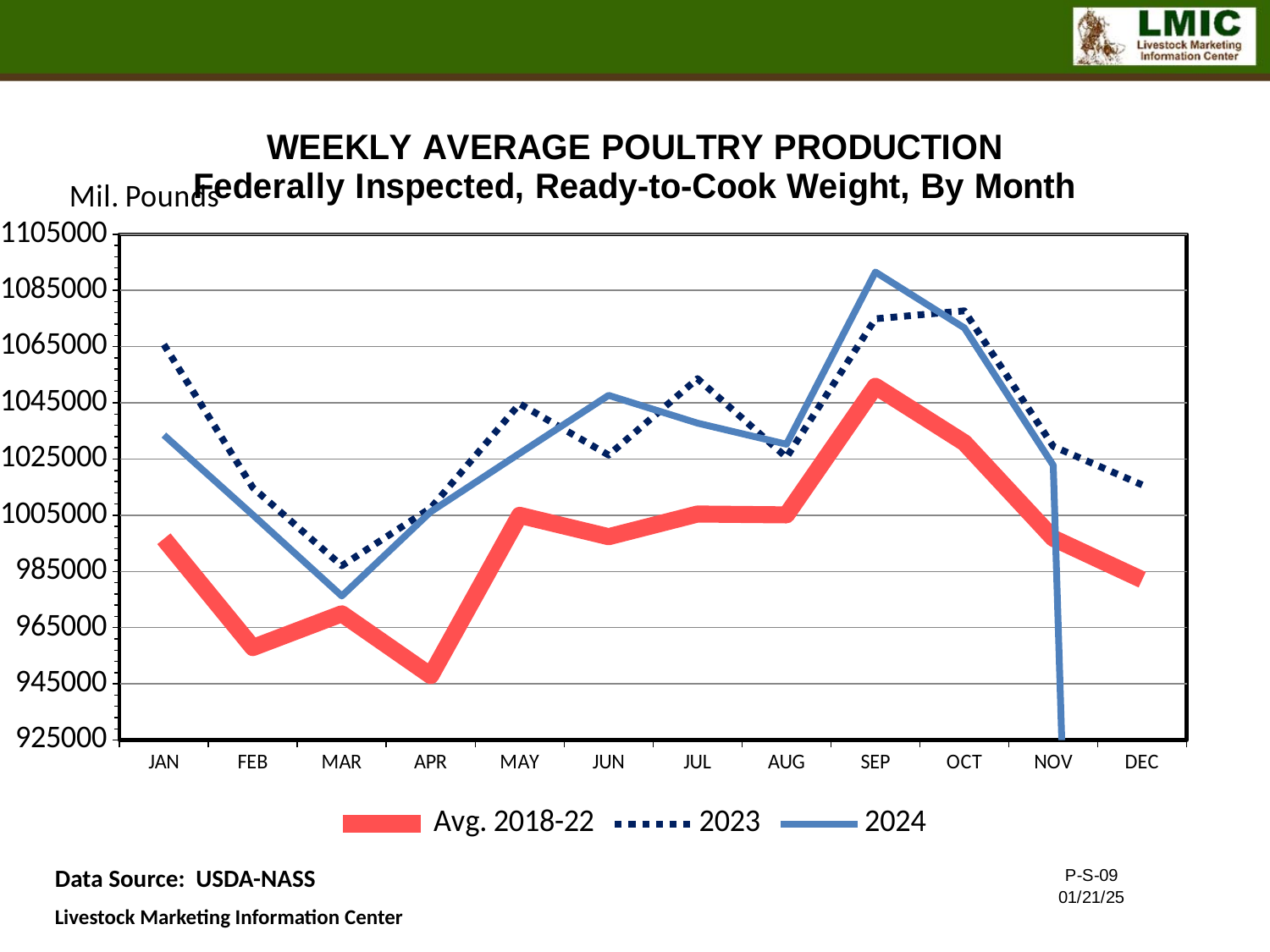
How many months are shown along the x axis? 12 Is the Avg. 2018-22 value for APR greater or less than 965000? less In which month is the Avg. 2018-22 series at its lowest? APR Is the 2024 value for SEP greater or less than 1085000? greater In which month is the 2023 series at its lowest? MAR Which series is higher in JAN, 2023 or 2024? 2023 What unit label is shown above the y axis? Mil. Pounds In which month does the 2024 series reach its highest value? SEP In which month does the Avg. 2018-22 series reach its highest value? SEP How many series does the legend list? 3 What kind of chart is shown on the slide? line chart Does the Avg. 2018-22 series rise or fall from JAN to APR? fall